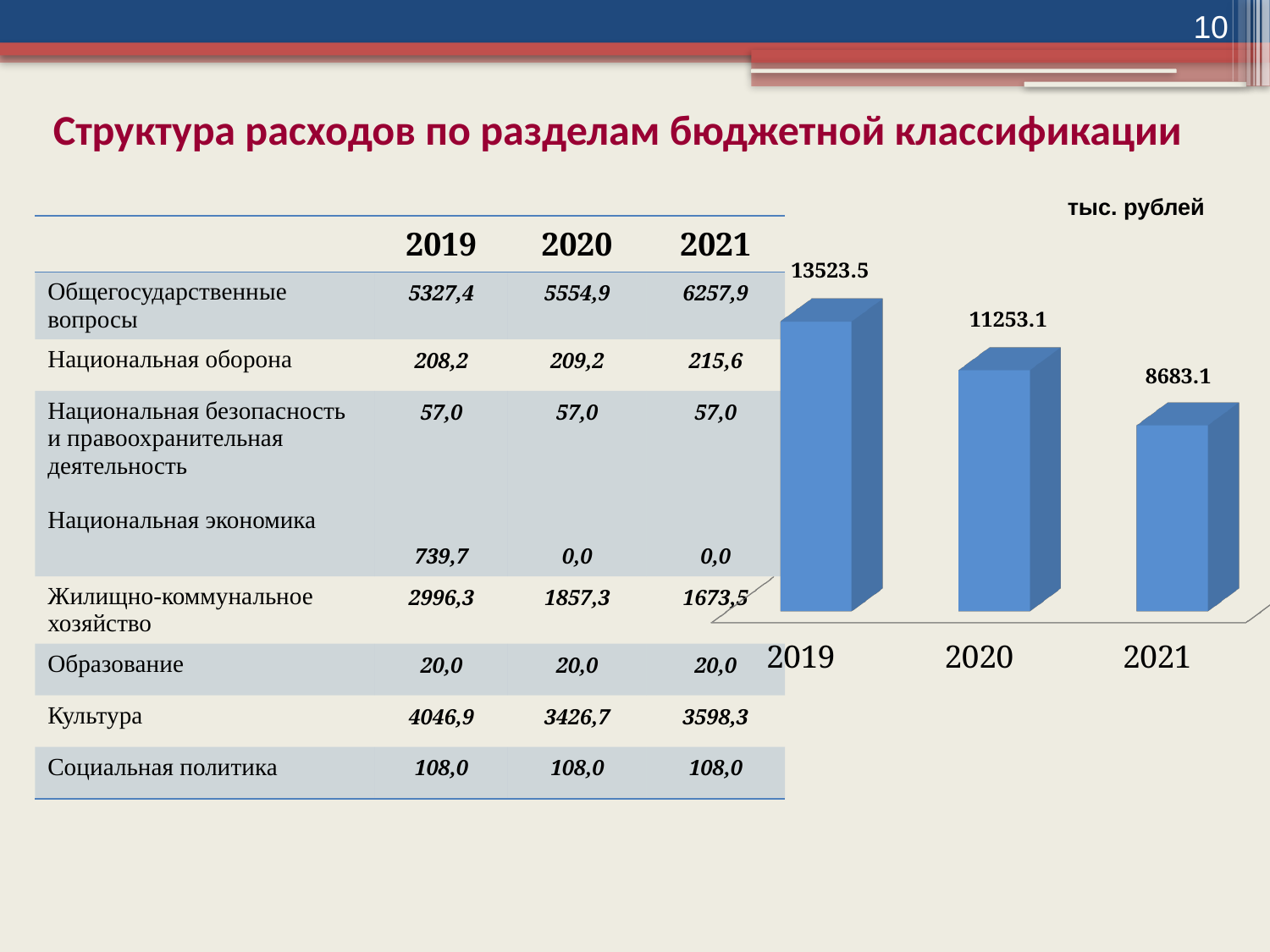
What is the difference between the 2020 and 2021 values in the bar chart? 2570.0 What is the value shown for 2021 in the bar chart? 8683.1 Which year has the lowest bar in the chart? 2021 What is the value shown for 2019 in the bar chart? 13523.5 What is the value shown for 2020 in the bar chart? 11253.1 Which year has the highest bar in the chart? 2019 What is the difference between the 2019 and 2021 values in the bar chart? 4840.4 What kind of chart is shown on the slide? bar chart How many bars are plotted in the chart? 3 Which is larger in the bar chart, the value for 2020 or the value for 2021? 2020 What is the difference between the 2019 and 2020 values in the bar chart? 2270.4 Do the values in the bar chart rise or fall from 2019 to 2021? fall